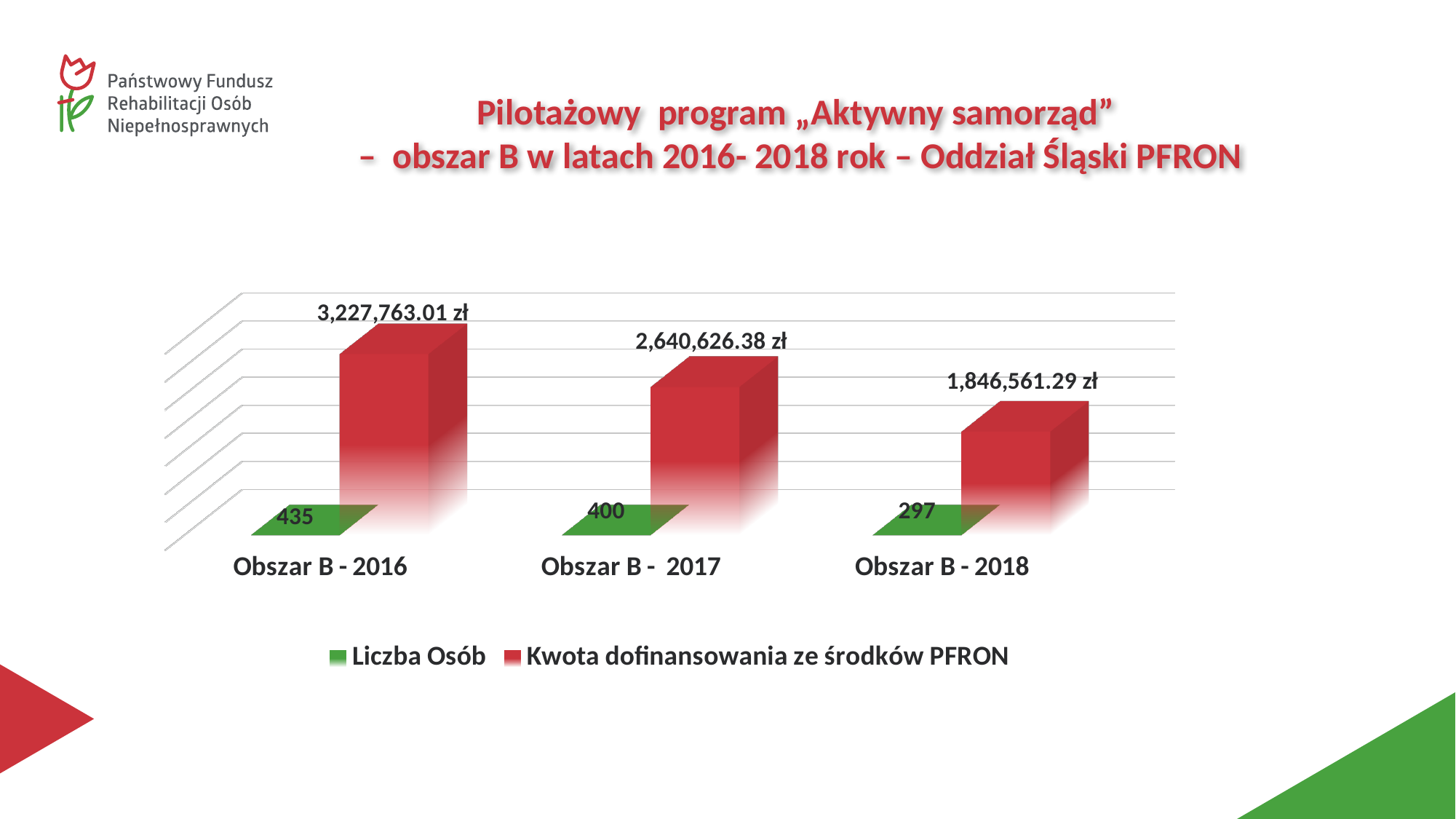
What is the Kwota dofinansowania ze środków PFRON for Obszar B - 2018? 1,846,561.29 zł Does the Kwota dofinansowania ze środków PFRON rise or fall from 2016 to 2018? fall What is the value of Liczba Osób for Obszar B - 2018? 297 Which is larger: Liczba Osób for Obszar B - 2017 or for Obszar B - 2018? Obszar B - 2017 Which category has the lowest Liczba Osób? Obszar B - 2018 What is the Kwota dofinansowania ze środków PFRON for Obszar B - 2017? 2,640,626.38 zł What is the difference in Kwota dofinansowania ze środków PFRON between Obszar B - 2017 and Obszar B - 2018? 794,065.09 zł How many categories are shown on the x axis of the chart? 3 What is the value of Liczba Osób for Obszar B - 2016? 435 What is the difference in Liczba Osób between Obszar B - 2016 and Obszar B - 2017? 35 Which category has the highest Kwota dofinansowania ze środków PFRON? Obszar B - 2016 How many series does the legend list? 2